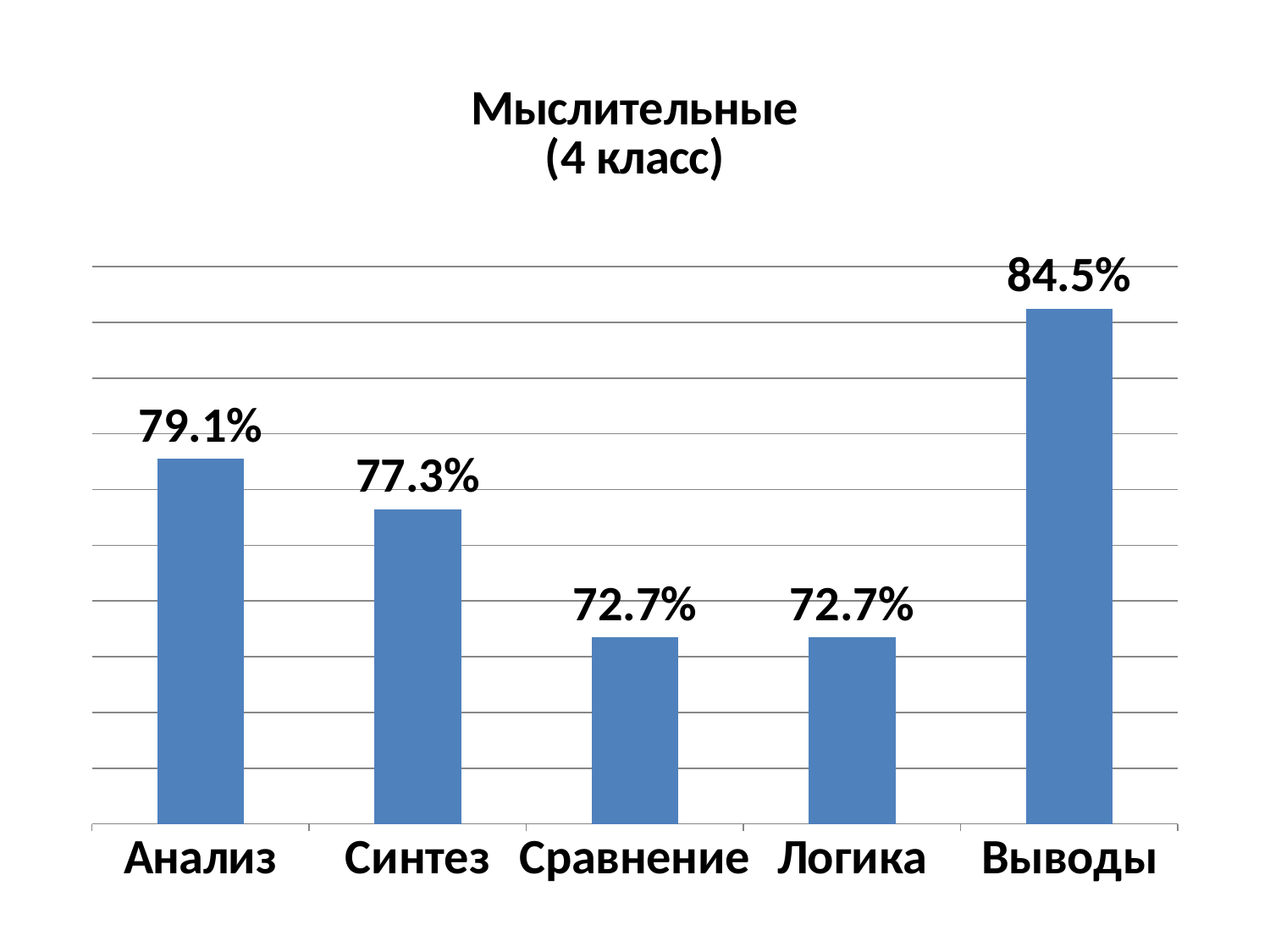
What is the difference between the values for Выводы and Анализ? 5.4% What is the value for Логика? 72.7% Which is larger, the value for Синтез or the value for Сравнение? Синтез What kind of chart is this? Bar chart How many categories are shown on the x axis? 5 Which two categories have the same value? Сравнение and Логика Which category has the highest value? Выводы What is the value for Синтез? 77.3% What is the title of the chart? Мыслительные (4 класс) What is the value for Выводы? 84.5% What is the value for Анализ? 79.1% What is the difference between the values for Анализ and Синтез? 1.8%